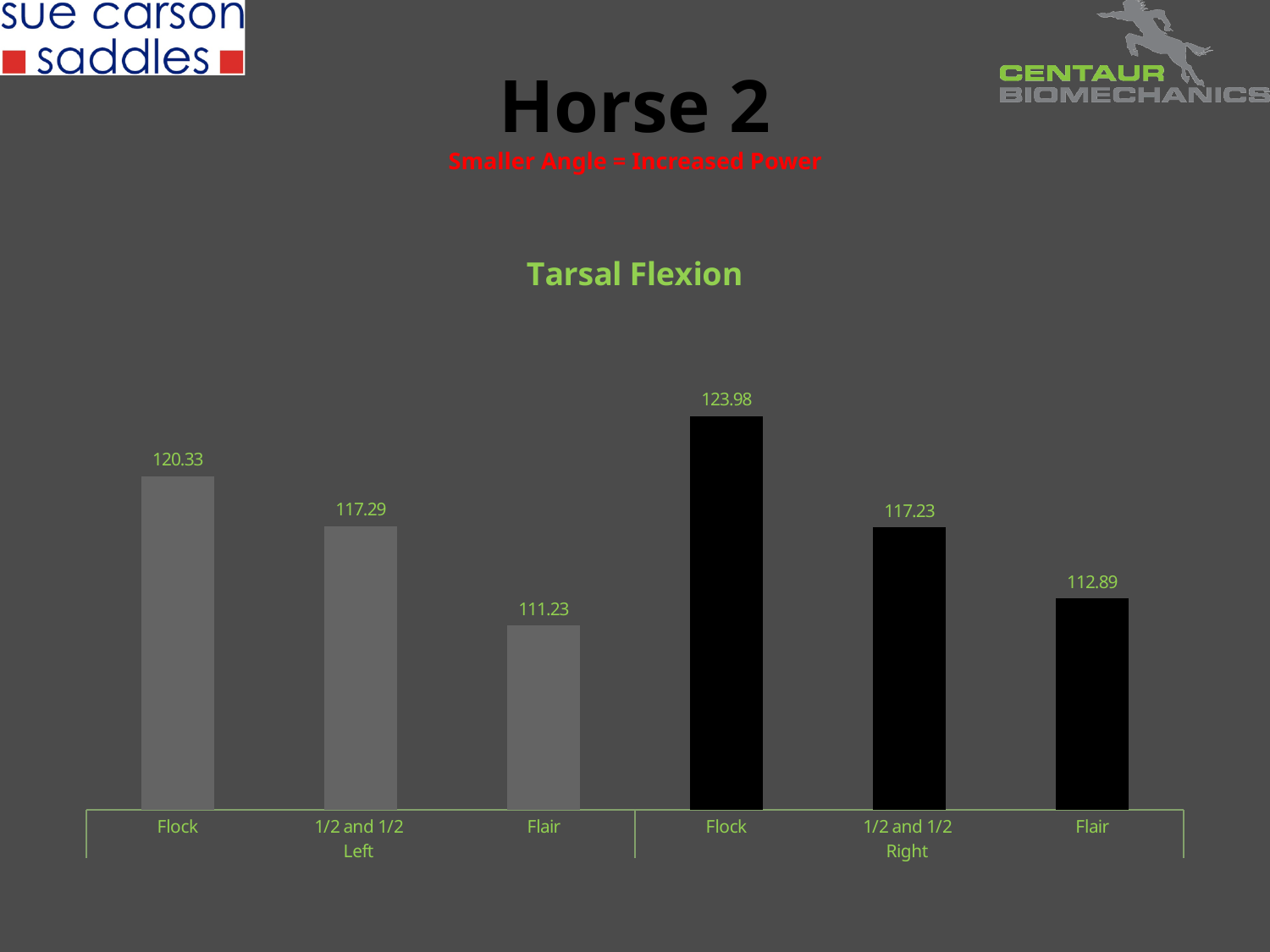
How many bars are plotted in the chart? 6 What is the Tarsal Flexion value for Flock on the Left side? 120.33 Which bar has the lowest value in the chart? Flair (Left) What is the difference between the Flock value on the Right and the Flock value on the Left? 3.65 Within the Left group, do the values rise or fall from Flock to Flair? Fall Which is larger, the Flair value on the Left or the Flair value on the Right? Flair (Right) What is the Tarsal Flexion value for Flair on the Right side? 112.89 What is the value for 1/2 and 1/2 on the Left side? 117.29 What kind of chart is shown on the slide? Bar chart What is the difference between the Flair values on the Left and Right sides? 1.66 Which bar has the highest value in the chart? Flock (Right) What is the title of the chart? Tarsal Flexion